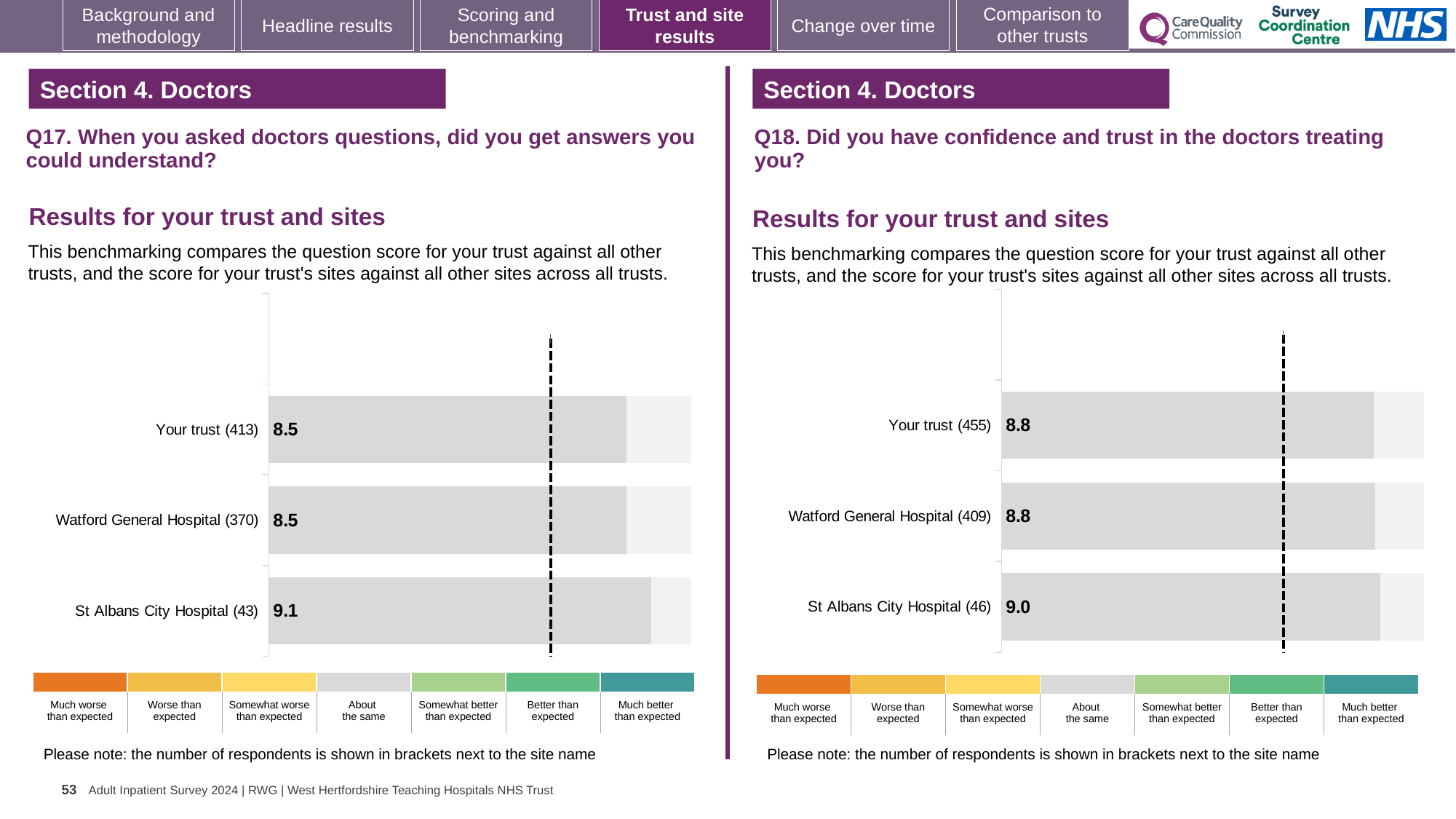
In the Q17 chart on the left, which site or trust has the highest score? St Albans City Hospital In the Q18 chart on the right, which site or trust has the highest score? St Albans City Hospital In the Q17 chart on the left, what is the difference between the scores for St Albans City Hospital and Watford General Hospital? 0.6 In the Q18 chart on the right, what is the difference between the scores for St Albans City Hospital and Your trust? 0.2 In the Q17 chart on the left, how many respondents are shown in brackets for Watford General Hospital? 370 In the Q18 chart on the right, what is the score for Watford General Hospital? 8.8 What kind of chart is used in the Q17 chart on the left? Bar chart In the Q17 chart on the left, what is the score for Your trust? 8.5 In the Q17 chart on the left, what is the score for St Albans City Hospital? 9.1 In the Q18 chart on the right, what is the score for St Albans City Hospital? 9.0 In the Q17 chart on the left, how many bars are plotted? 3 In the Q18 chart on the right, how many respondents are shown in brackets for Your trust? 455